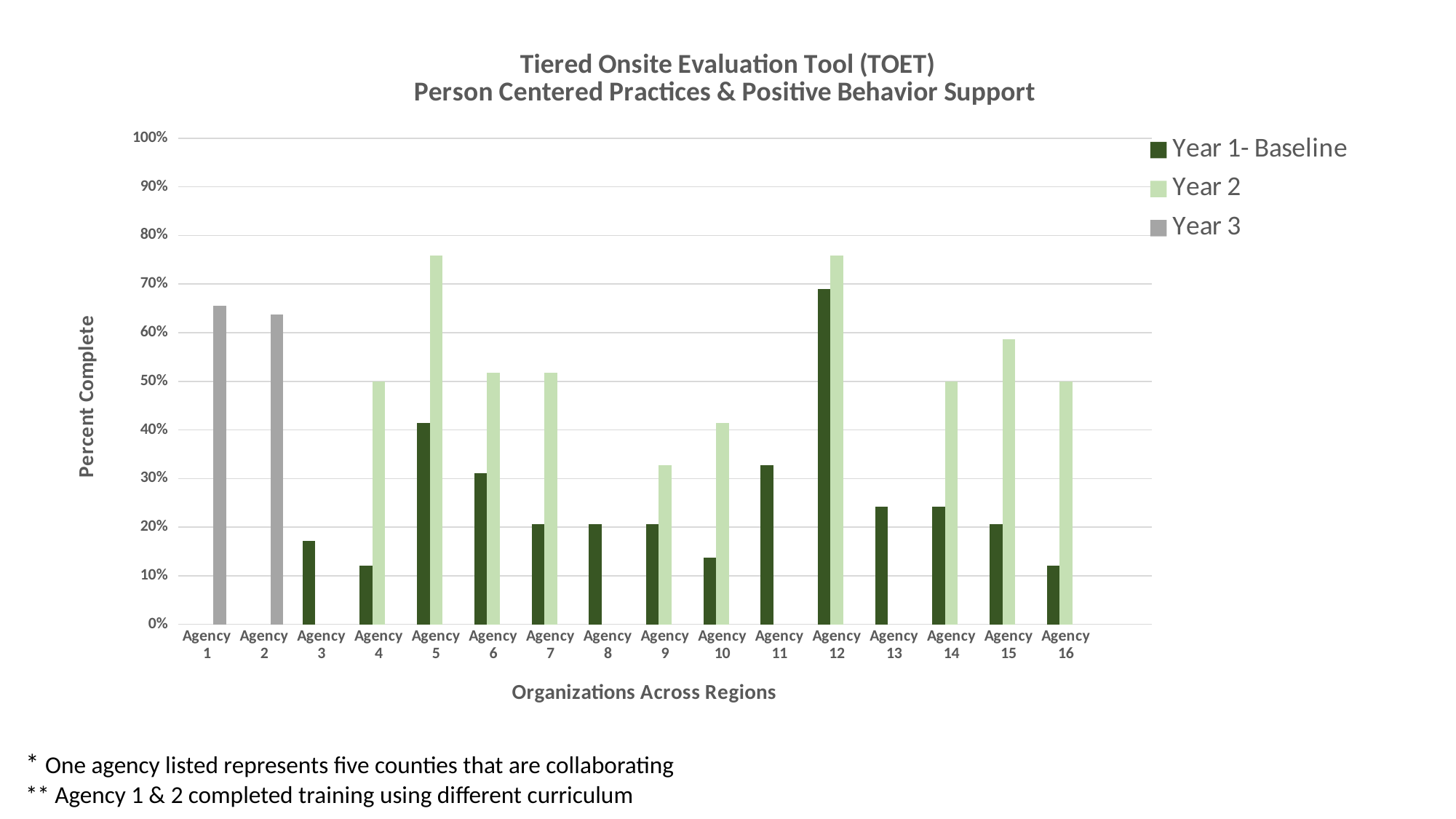
Is the Year 2 value for Agency 5 greater or less than 70%? greater What is the title of the y axis? Percent Complete Is the Year 1- Baseline value for Agency 4 greater or less than 20%? less What kind of chart is shown on the slide? bar chart How many agencies are shown along the x axis? 16 How many series does the legend list? 3 Which is larger, the Year 2 value for Agency 15 or for Agency 14? Agency 15 Which is larger, the Year 1- Baseline value for Agency 5 or for Agency 6? Agency 5 Which agency has the highest Year 1- Baseline value? Agency 12 Is the Year 3 value for Agency 1 greater or less than 60%? greater